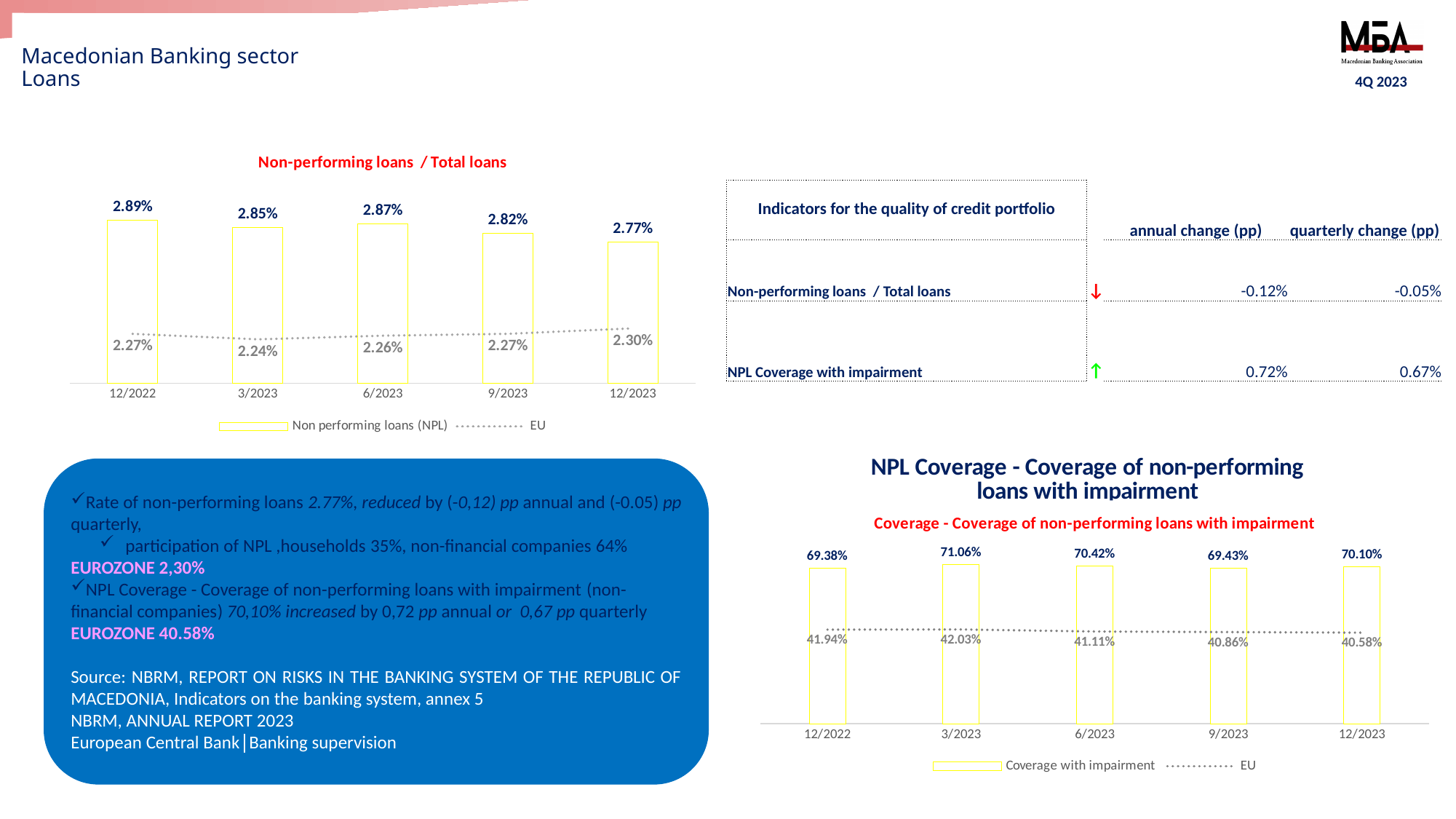
In the 'Non-performing loans / Total loans' chart, which period has the highest Non performing loans (NPL) value? 12/2022 In the 'Coverage - Coverage of non-performing loans with impairment' chart, which period has the lowest Coverage with impairment value? 12/2022 In the 'Coverage - Coverage of non-performing loans with impairment' chart, what is the EU value for 12/2023? 40.58% What kind of chart is the 'Non-performing loans / Total loans' chart? bar chart with a line In the 'Coverage - Coverage of non-performing loans with impairment' chart, how many series does the legend list? 2 In the 'Non-performing loans / Total loans' chart, do the Non performing loans (NPL) values generally rise or fall from 12/2022 to 12/2023? fall In the 'Non-performing loans / Total loans' chart, what is the EU value for 3/2023? 2.24% In the 'Non-performing loans / Total loans' chart, what is the Non performing loans (NPL) value for 12/2023? 2.77% In the 'Coverage - Coverage of non-performing loans with impairment' chart, what is the Coverage with impairment value for 3/2023? 71.06% In the 'Non-performing loans / Total loans' chart, what is the difference between the NPL value and the EU value for 12/2022? 0.62% In the 'Coverage - Coverage of non-performing loans with impairment' chart, is the Coverage with impairment value for 6/2023 larger or the value for 9/2023? 6/2023 In the 'Non-performing loans / Total loans' chart, how many periods are shown on the x axis? 5